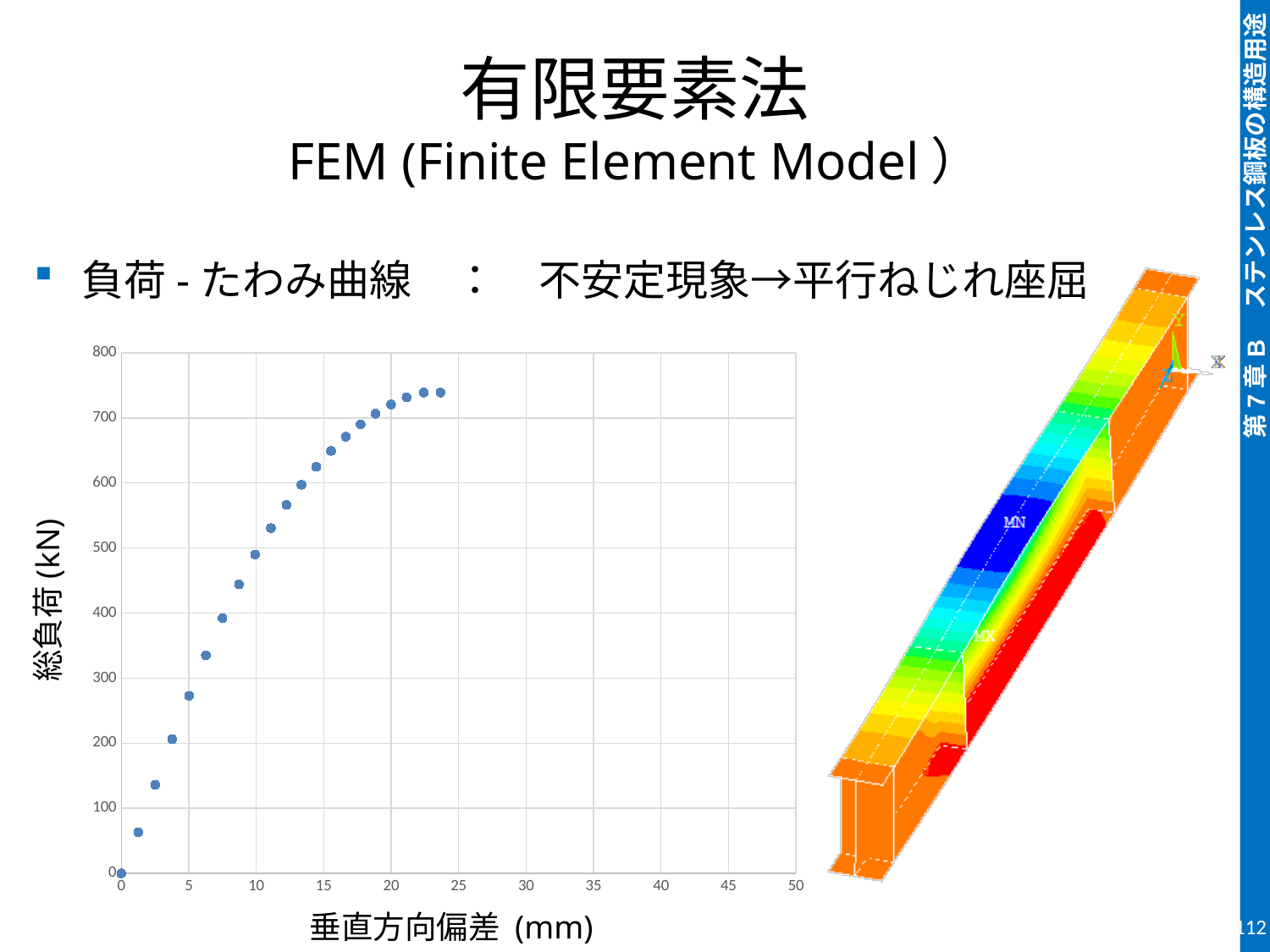
What is the maximum value shown on the vertical axis of the chart? 800 Is the total load at a vertical deviation of 10 mm greater or less than 400 kN? greater Is the highest plotted total load greater or less than 800 kN? less Do the plotted values rise or fall as the horizontal deviation increases along the x axis? rise What kind of chart is shown on the slide? scatter chart Is the largest vertical deviation plotted greater or less than 25 mm? less What is the title of the horizontal axis of the chart? 垂直方向偏差 (mm) Which is larger: the total load at a vertical deviation of 15 mm or at 5 mm? 15 mm What is the title of the vertical axis of the chart? 総負荷 (kN)